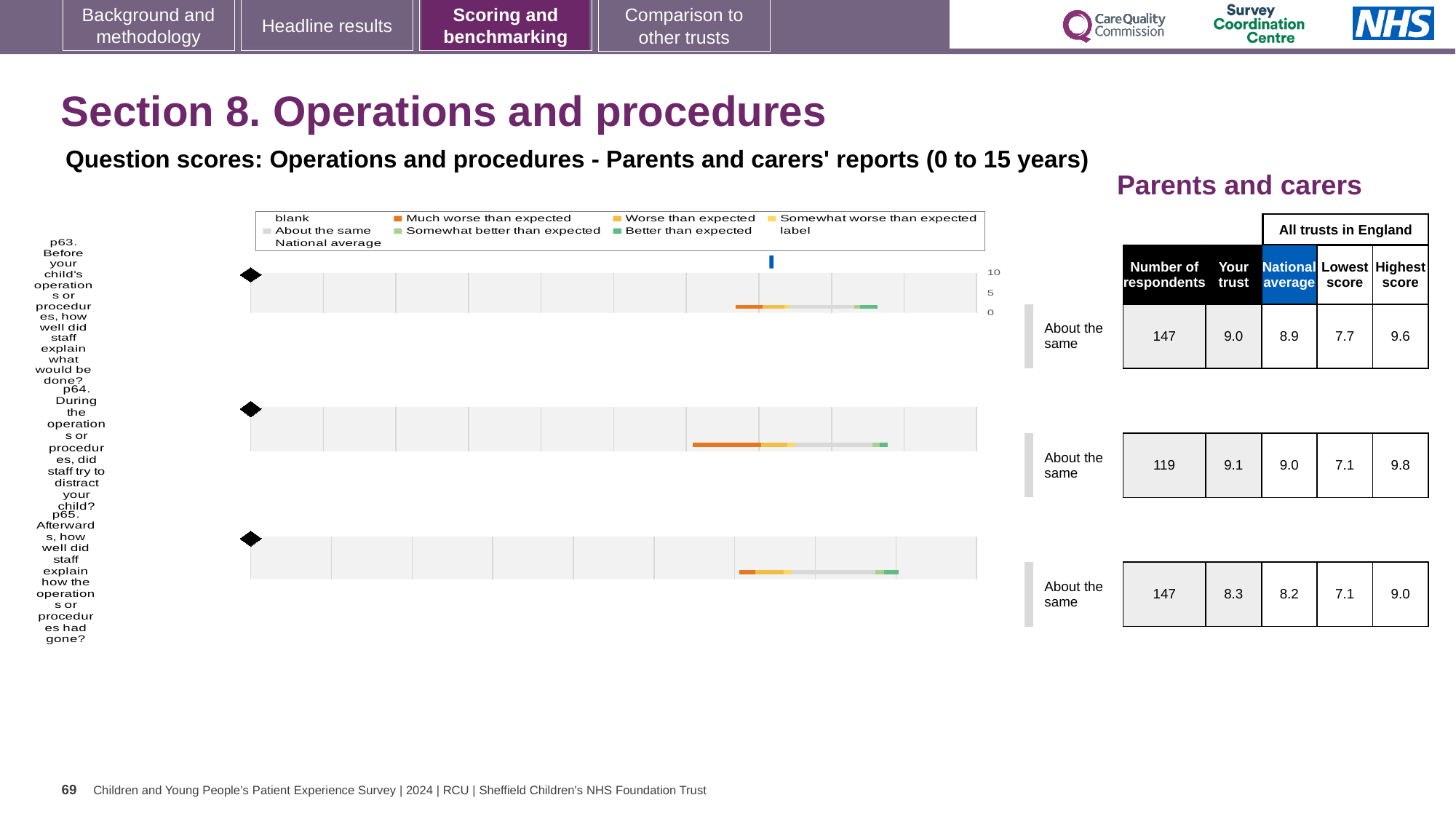
Which question has the lowest national average score? p65 What is the difference between the highest score and the lowest score for question p65? 1.9 In the chart legend, which colour represents 'Much worse than expected'? orange Which question has the highest 'Your trust' score? p64 How many survey questions (p63, p64, p65) have a benchmarking chart on this slide? 3 What benchmark category is shown for question p64? About the same What is the 'Your trust' score for question p63 (how well staff explained what would be done)? 9.0 What kind of chart is used for each question's benchmarking display? bar chart What is the highest score among all trusts in England for question p64? 9.8 What is the national average score for question p65 (how well staff explained how the operations or procedures had gone)? 8.2 What is the number of respondents for question p64 (did staff try to distract your child)? 119 What is the lowest score among all trusts in England for question p63? 7.7